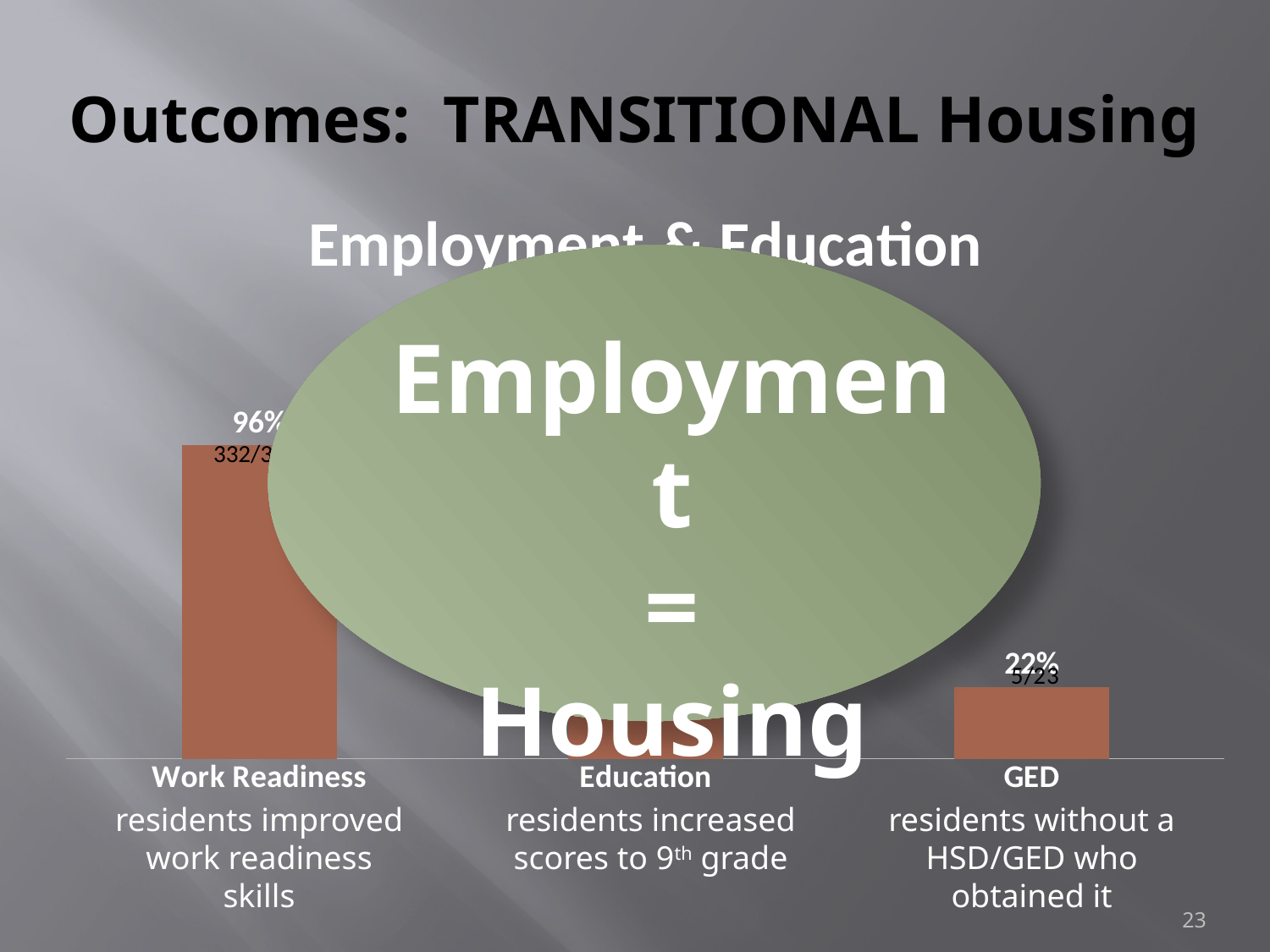
What is the percentage shown for Work Readiness? 96% Which category has the highest value in the chart? Work Readiness What is the difference between the Work Readiness percentage and the GED percentage? 74% What is the main title of the slide? Outcomes: TRANSITIONAL Housing What is the percentage shown for GED? 22% What fraction is shown above the GED bar? 5/23 What kind of chart is shown on the slide? bar chart What is the title of the chart? Employment & Education Which is larger, the value for Work Readiness or the value for GED? Work Readiness How many categories are shown in the chart? 3 Which category has the shortest bar in the chart? GED